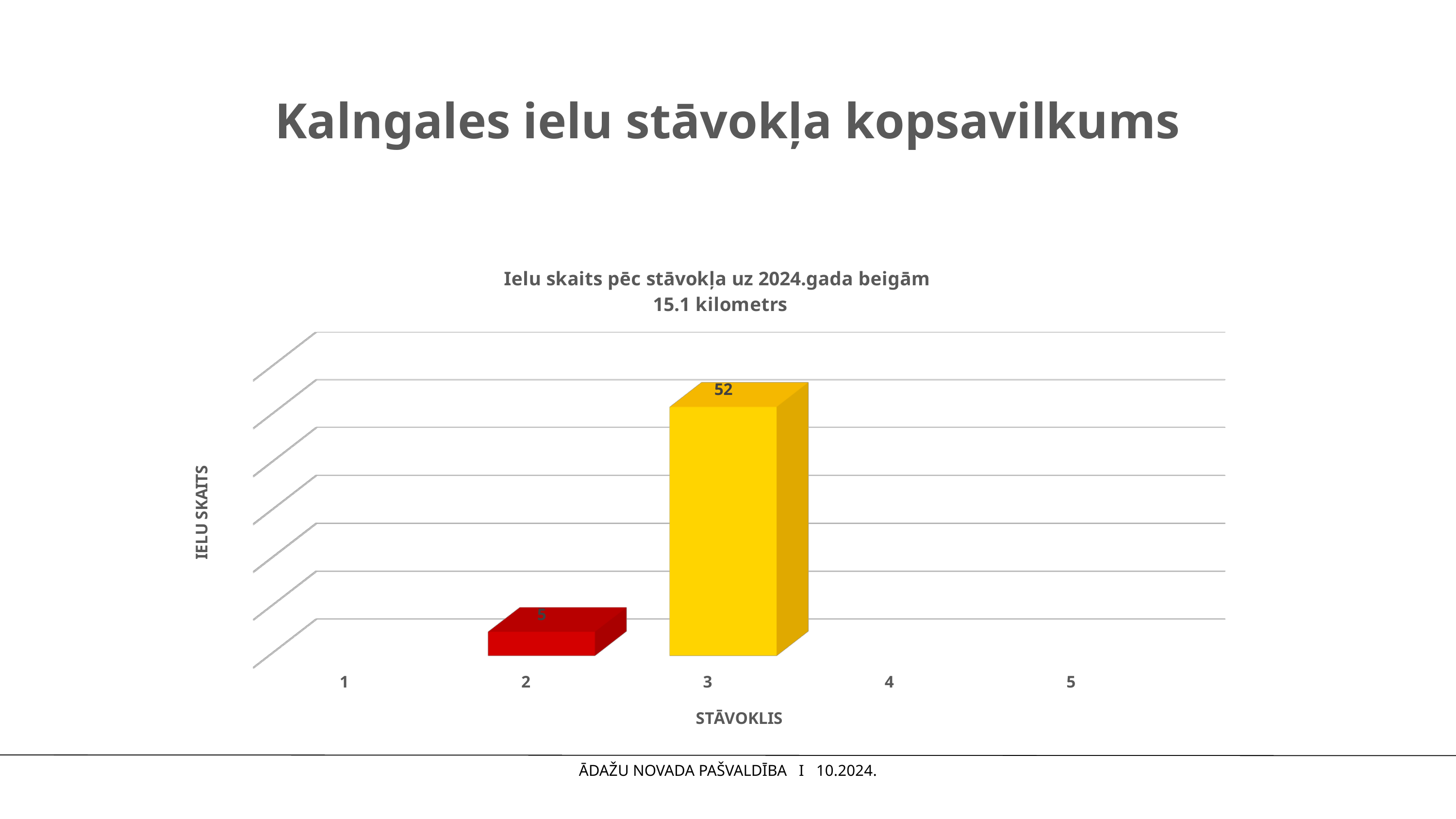
What is the difference between the values for category 3 and category 2? 47 What is the title of the chart? Ielu skaits pēc stāvokļa uz 2024.gada beigām 15.1 kilometrs How many categories are shown on the x axis of the chart? 5 What is the value for category 3 (stāvoklis 3) in the chart? 52 What is the label of the x axis of the chart? STĀVOKLIS What kind of chart is shown on the slide? Bar chart What is the value for category 2 (stāvoklis 2) in the chart? 5 Which category has the highest value in the chart? 3 Which is larger, the value for category 2 or the value for category 3? Category 3 How many categories have a visible bar in the chart? 2 What is the total of the two plotted bars (categories 2 and 3)? 57